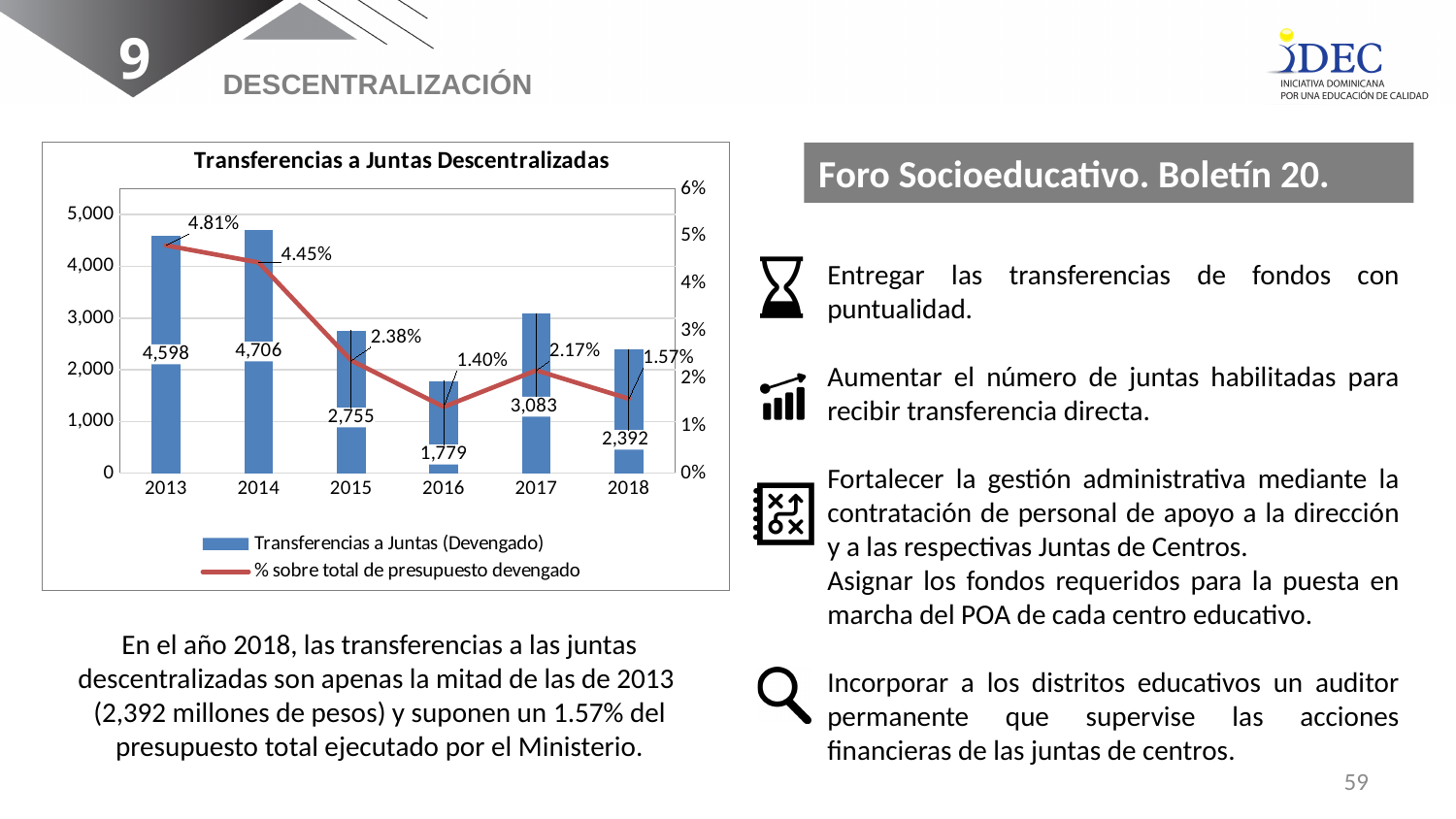
What is the value of Transferencias a Juntas (Devengado) for 2014? 4,706 What is the difference between the Transferencias a Juntas (Devengado) values for 2013 and 2018? 2,206 What is the title of the chart on the slide? Transferencias a Juntas Descentralizadas What kind of chart is used to show Transferencias a Juntas (Devengado)? Bar chart What percentage of the total budget (% sobre total de presupuesto devengado) do the transfers represent in 2013? 4.81% Which year has the lowest value of Transferencias a Juntas (Devengado)? 2016 How many years are shown on the x axis of the chart? 6 How many series does the legend of the chart list? 2 What is the value of Transferencias a Juntas (Devengado) for 2016? 1,779 What percentage of the total budget (% sobre total de presupuesto devengado) do the transfers represent in 2018? 1.57% Which year has the highest value of Transferencias a Juntas (Devengado)? 2014 Which year has a larger value of Transferencias a Juntas (Devengado), 2015 or 2017? 2017